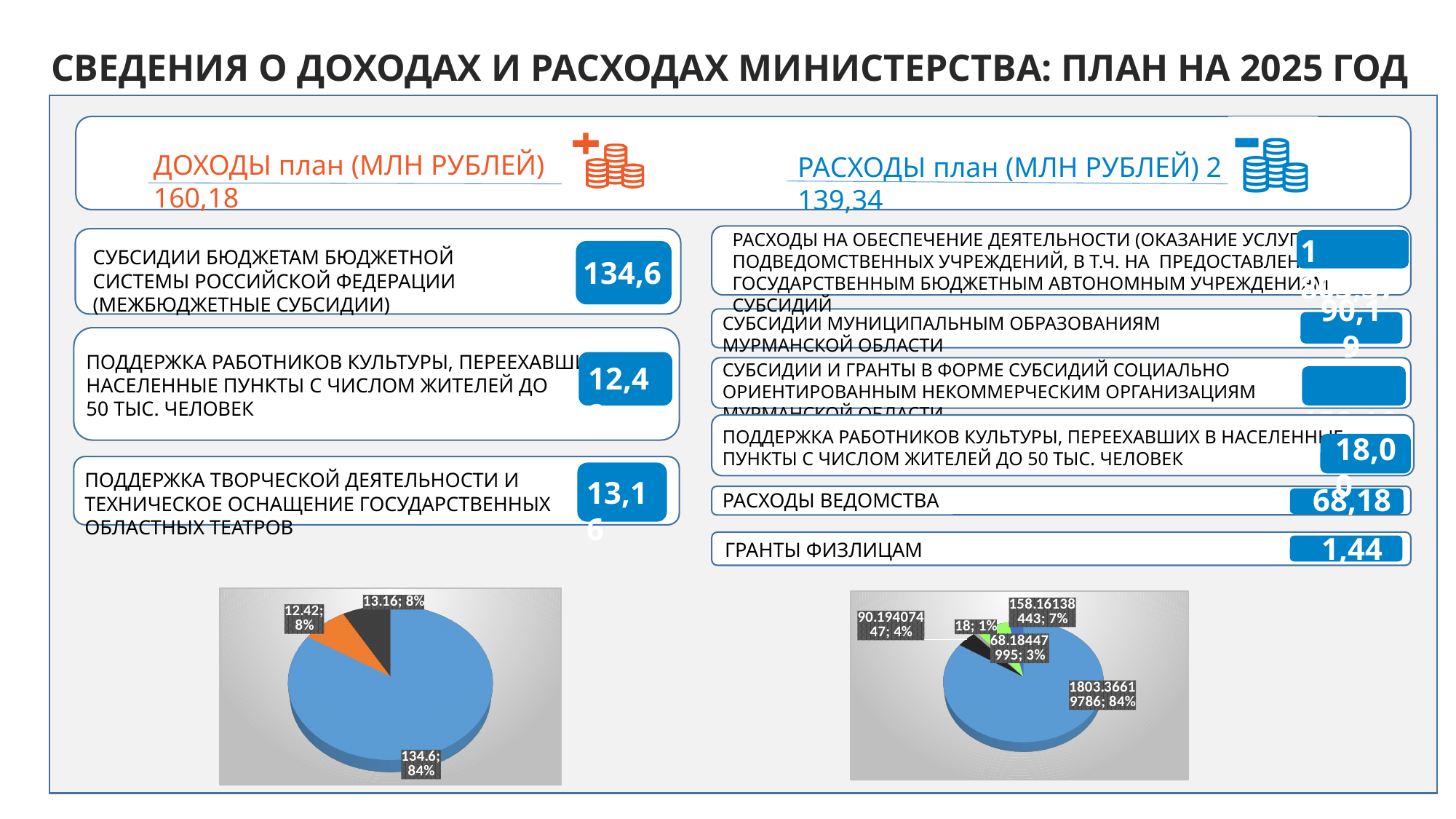
In the pie chart on the left side of the slide, what share of the pie does the slice labelled 12.42 represent? 8% How many slices does the pie chart on the left side of the slide have? 3 In the pie chart on the right side of the slide, what share of the pie does the slice labelled 68.18447995 represent? 3% In the pie chart on the left side of the slide, what is the value of the largest slice? 134.6 What kind of chart is the chart on the left side of the slide? pie chart In the pie chart on the right side of the slide, what is the value of the largest slice? 1803.36619786 In the pie chart on the left side of the slide, what is the value of the orange slice? 12.42 In the pie chart on the right side of the slide, which slice is larger: the one labelled 158.16138443 or the one labelled 90.19407447? 158.16138443 How many slices does the pie chart on the right side of the slide have? 5 In the pie chart on the right side of the slide, what is the value of the smallest slice? 18 In the pie chart on the left side of the slide, what is the total of all three slices? 160.18 In the pie chart on the left side of the slide, what is the difference between the slice labelled 13.16 and the slice labelled 12.42? 0.74